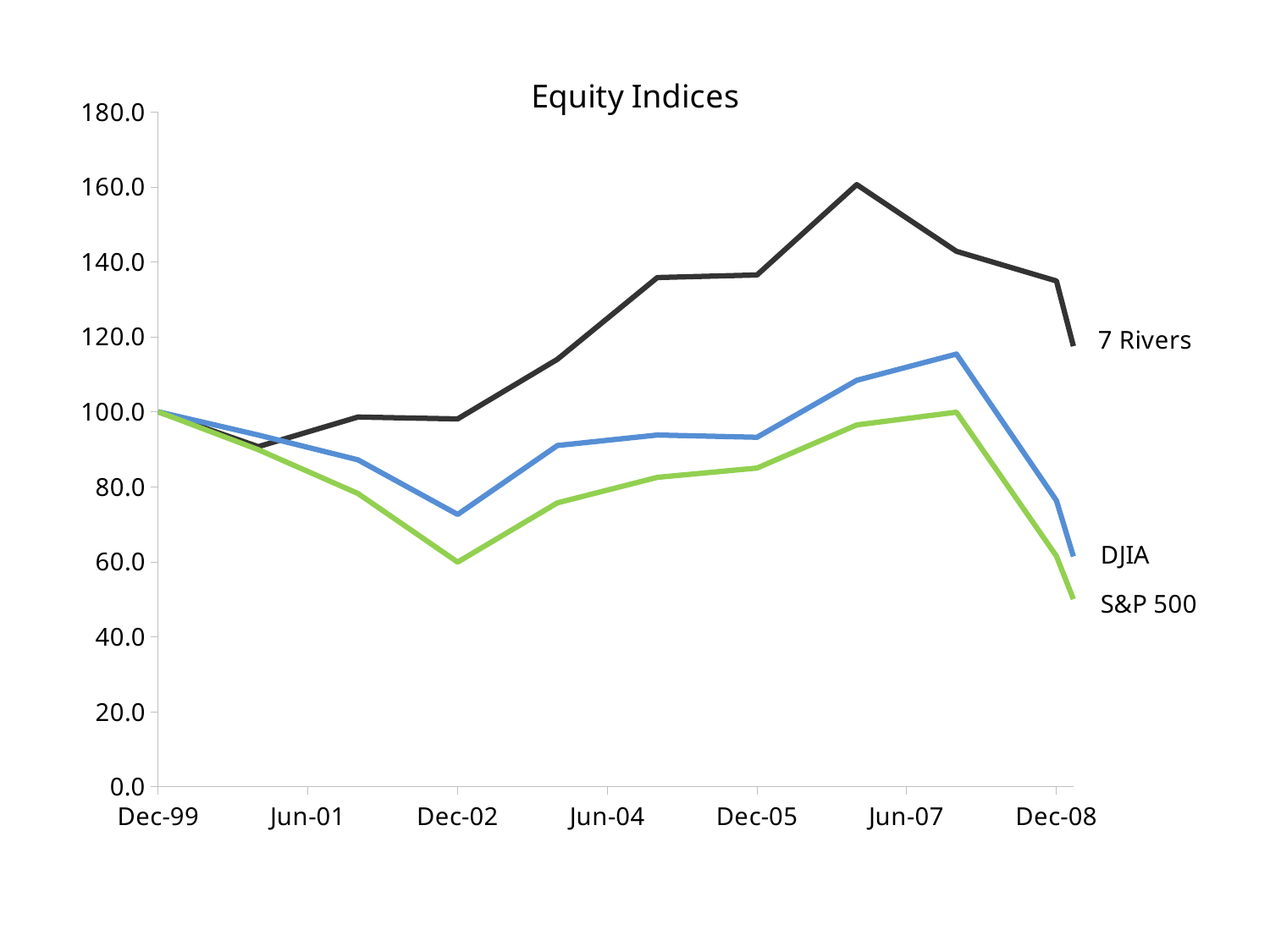
What is the title of the chart? Equity Indices At Dec-02, which is larger: DJIA or S&P 500? DJIA How many date labels are shown on the x axis of the chart? 7 Is the value for DJIA at Dec-02 greater or less than 80? less Which series has the highest value at Dec-08? 7 Rivers What kind of chart is shown on the slide? line chart What value do all three series start at in Dec-99? 100.0 How many series are plotted in the Equity Indices chart? 3 Does the S&P 500 line rise or fall between Jun-07 and Dec-08? fall Which series has the lowest value at Dec-08? S&P 500 Is the peak value of 7 Rivers greater or less than 140? greater